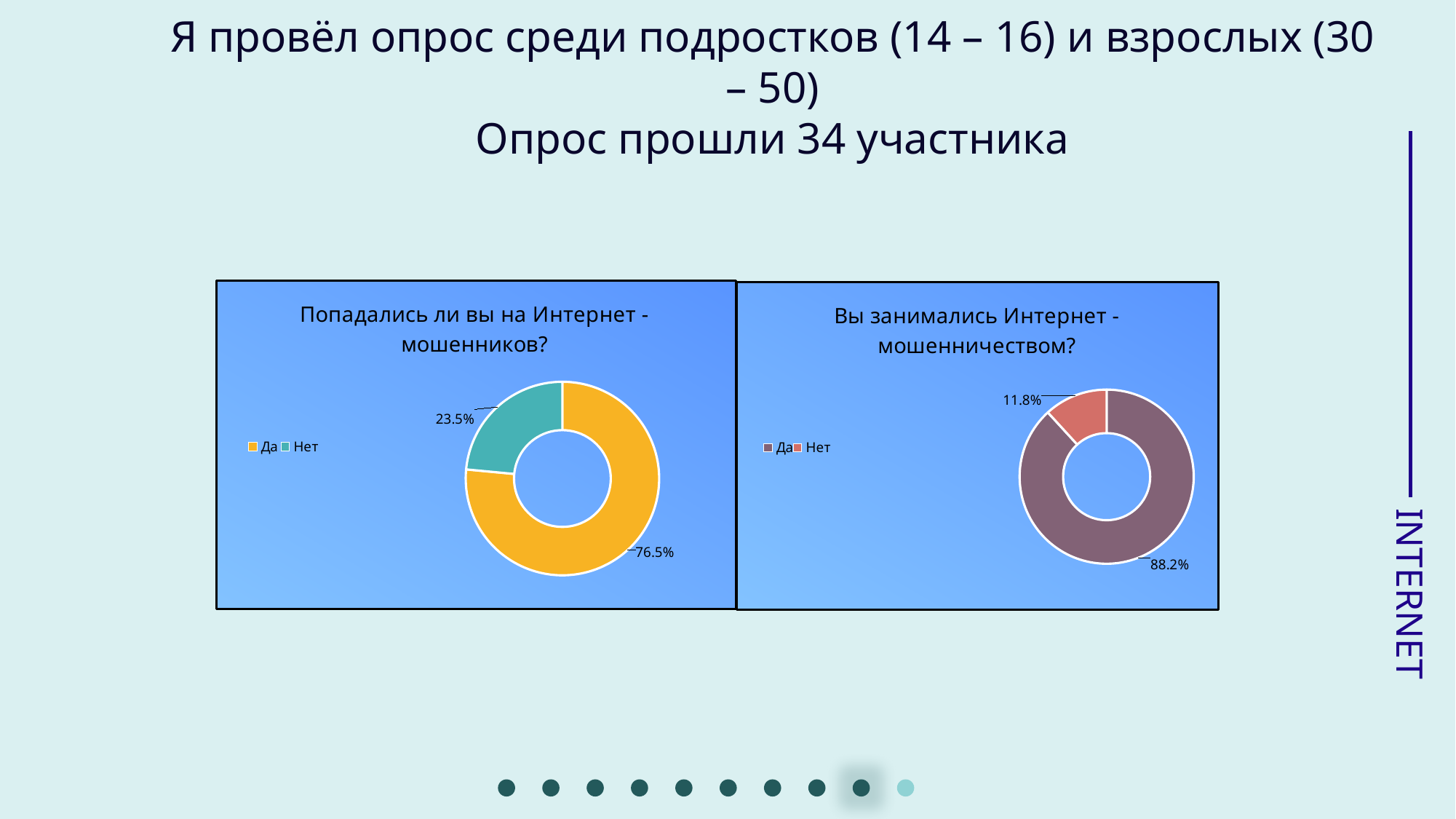
In the left chart titled "Попадались ли вы на Интернет - мошенников?", what percentage answered "Да"? 76.5% In the left chart, what colour represents "Нет"? teal In the right chart titled "Вы занимались Интернет - мошенничеством?", what percentage is shown for "Нет"? 11.8% In the left chart, which answer has the larger share, "Да" or "Нет"? Да In the left chart, what is the difference in percentage points between "Да" and "Нет"? 53 percentage points In the right chart titled "Вы занимались Интернет - мошенничеством?", what percentage is shown for "Да"? 88.2% In the left chart titled "Попадались ли вы на Интернет - мошенников?", what percentage answered "Нет"? 23.5% What type of chart is used in the left chart? doughnut chart How many categories does the legend of the right chart list? 2 Is the "Да" share in the left chart larger or smaller than the "Да" share in the right chart? smaller In the right chart, what is the difference in percentage points between "Да" and "Нет"? 76.4 percentage points In the right chart, which answer has the smaller share? Нет